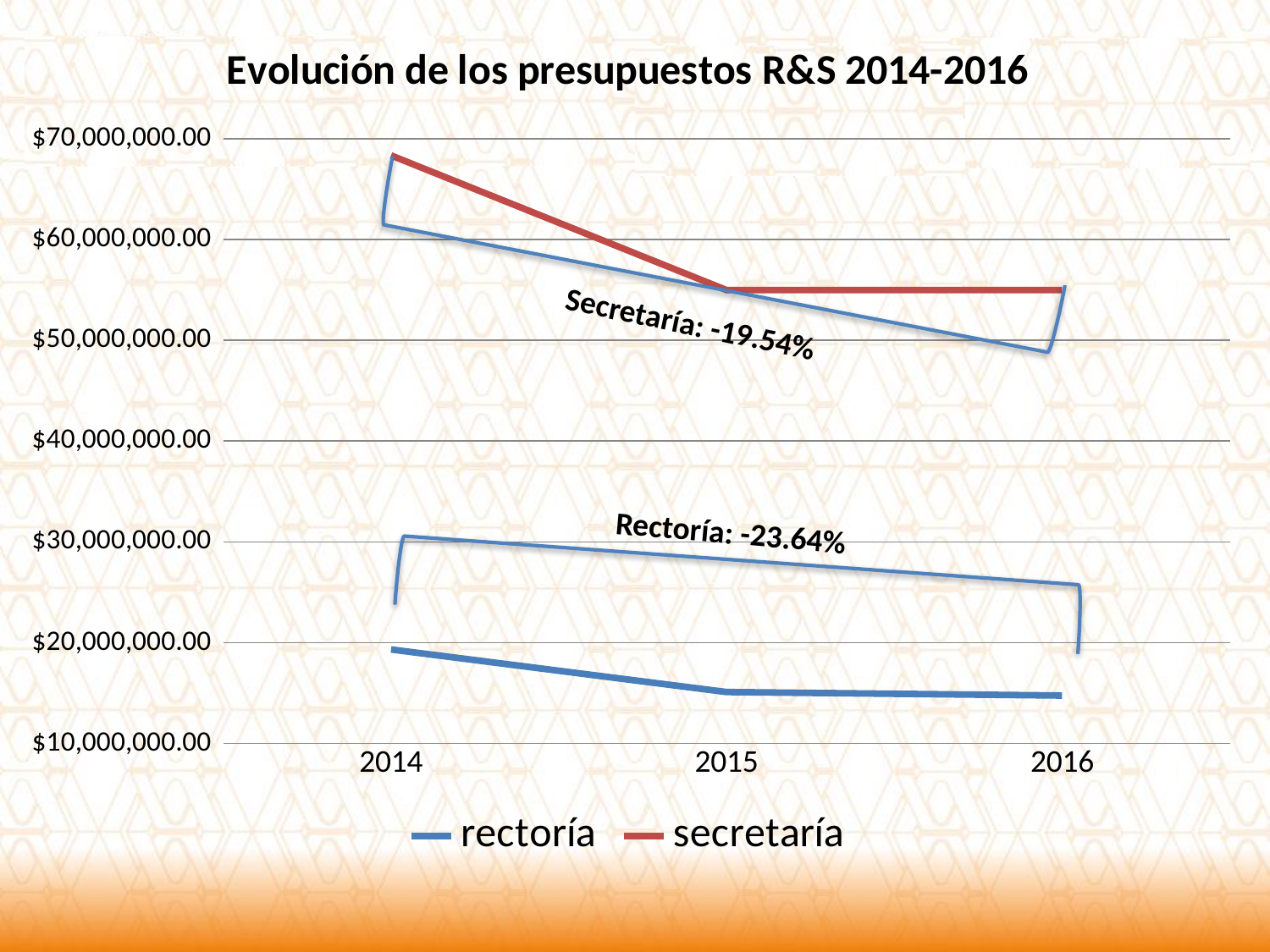
What kind of chart is shown on the slide? line chart Which series has the larger value in 2014, rectoría or secretaría? secretaría Does the secretaría budget rise or fall from 2014 to 2016? fall Does the rectoría budget rise or fall from 2014 to 2016? fall How many years are plotted along the x axis? 3 What percentage change is annotated for Rectoría on the chart? -23.64% Is the value for rectoría in 2016 greater or less than $10,000,000.00? greater How many series does the legend list? 2 Is the value for rectoría in 2015 greater or less than $20,000,000.00? less Is the value for secretaría in 2015 greater or less than $50,000,000.00? greater What percentage change is annotated for Secretaría on the chart? -19.54%